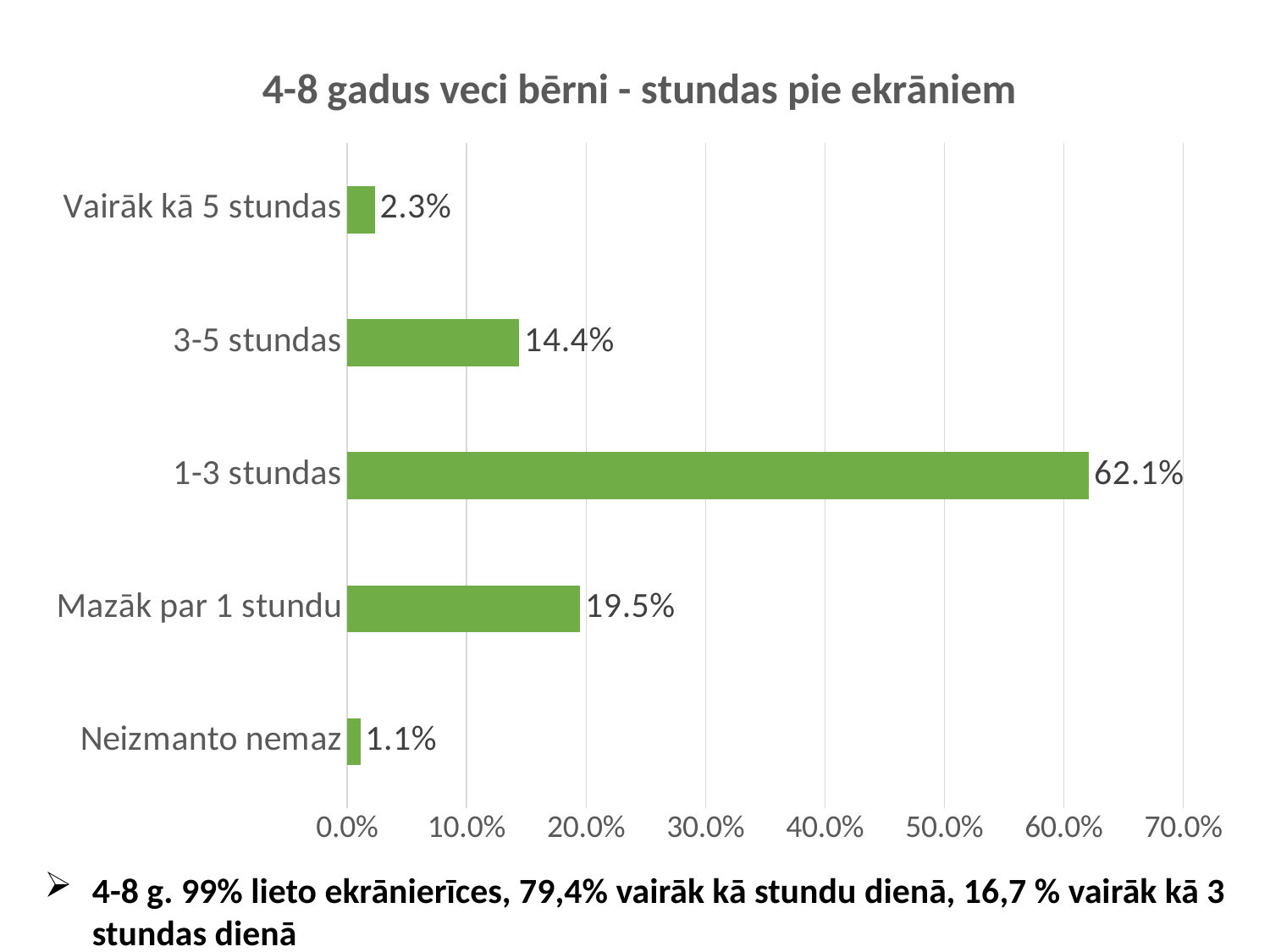
Is the value for '1-3 stundas' greater or less than 60.0%? greater What is the value for '1-3 stundas'? 62.1% Which category has the highest value? 1-3 stundas How many categories are shown in the chart? 5 Which category has the lowest value? Neizmanto nemaz What is the value for 'Neizmanto nemaz'? 1.1% What is the value for 'Vairāk kā 5 stundas'? 2.3% What is the value for 'Mazāk par 1 stundu'? 19.5% What kind of chart is shown on the slide? bar chart What is the difference between the values for '3-5 stundas' and 'Vairāk kā 5 stundas'? 12.1% Which is larger, the value for '3-5 stundas' or the value for 'Mazāk par 1 stundu'? Mazāk par 1 stundu What is the difference between the values for '1-3 stundas' and 'Mazāk par 1 stundu'? 42.6%